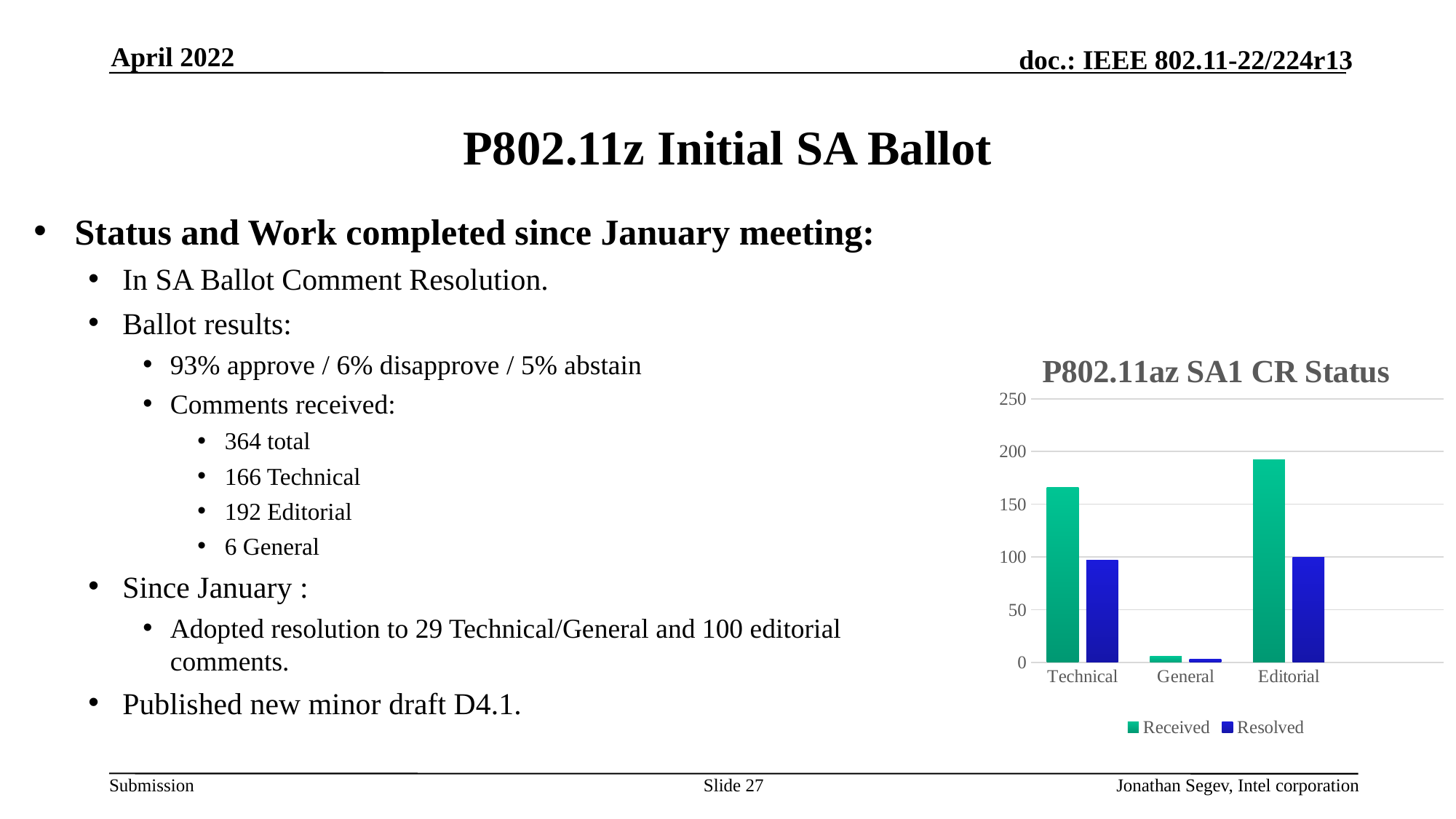
Which category has the lowest Received value? General What kind of chart is shown on the slide? bar chart What is the title of the chart? P802.11az SA1 CR Status Is the Received value for General greater or less than 50? less How many series does the chart legend list? 2 For Technical, which is larger, Received or Resolved? Received Which category has the lowest Resolved value? General How many categories are shown on the x axis of the chart? 3 Which category has the highest Received value? Editorial Which is larger, the Received value for Technical or the Received value for Editorial? Editorial Is the Received value for Technical greater or less than 150? greater Is the Received value for Editorial greater or less than 200? less